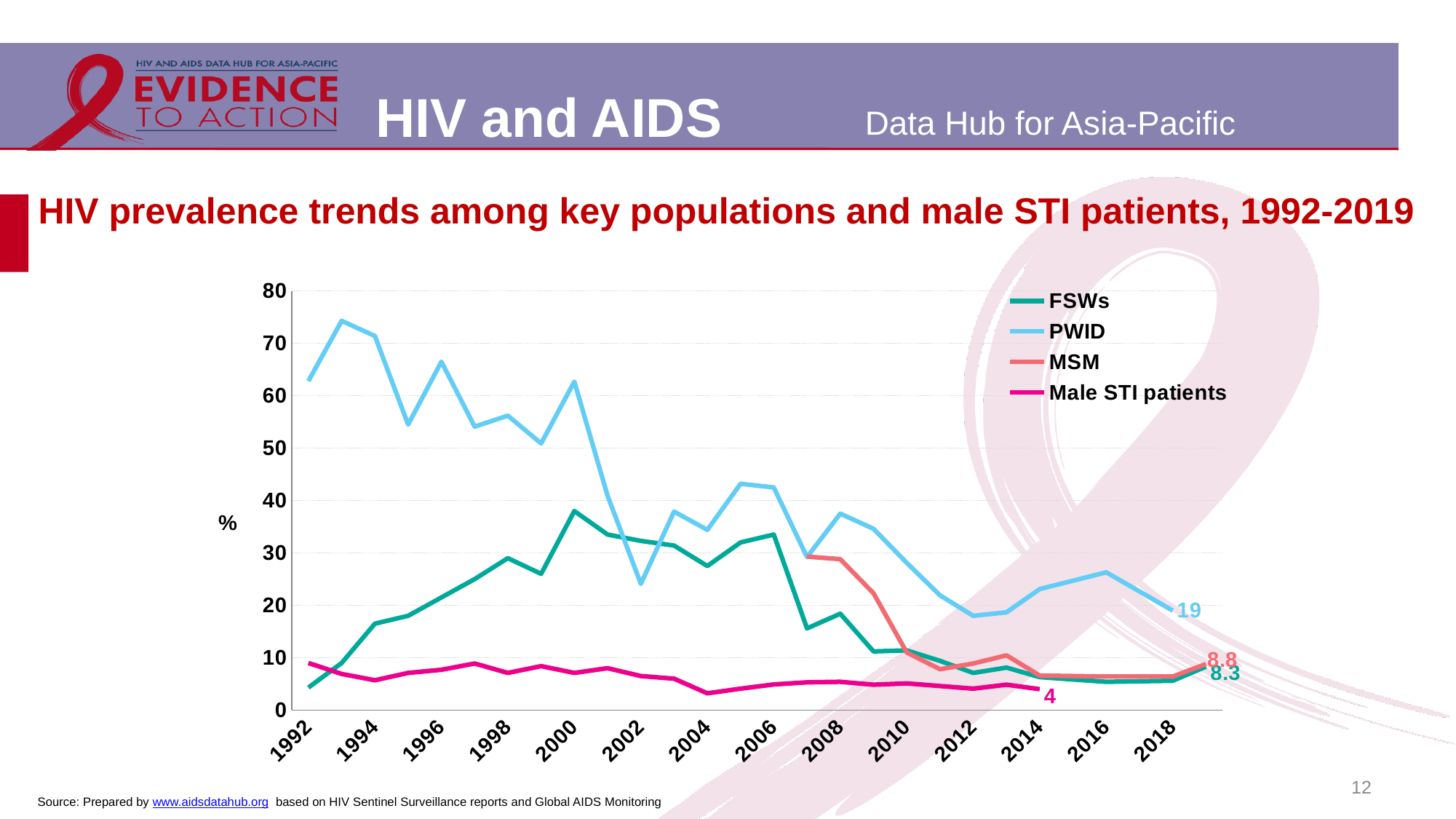
What is the labelled final value for PWID at the end of the series? 19 What is the labelled last value for Male STI patients? 4 What kind of chart is shown on the slide? line chart Is the value for PWID in 1993 greater or less than 70? greater Which series has the lowest labelled final value? Male STI patients What is the title of the chart? HIV prevalence trends among key populations and male STI patients, 1992-2019 Which series has the highest labelled final value? PWID How many series does the legend list? 4 What is the labelled final value for MSM at the end of the series? 8.8 What is the difference between the labelled final values for PWID and MSM? 10.2 Does the PWID line overall rise or fall from 1992 to 2019? fall What is the labelled final value for FSWs at the end of the series? 8.3